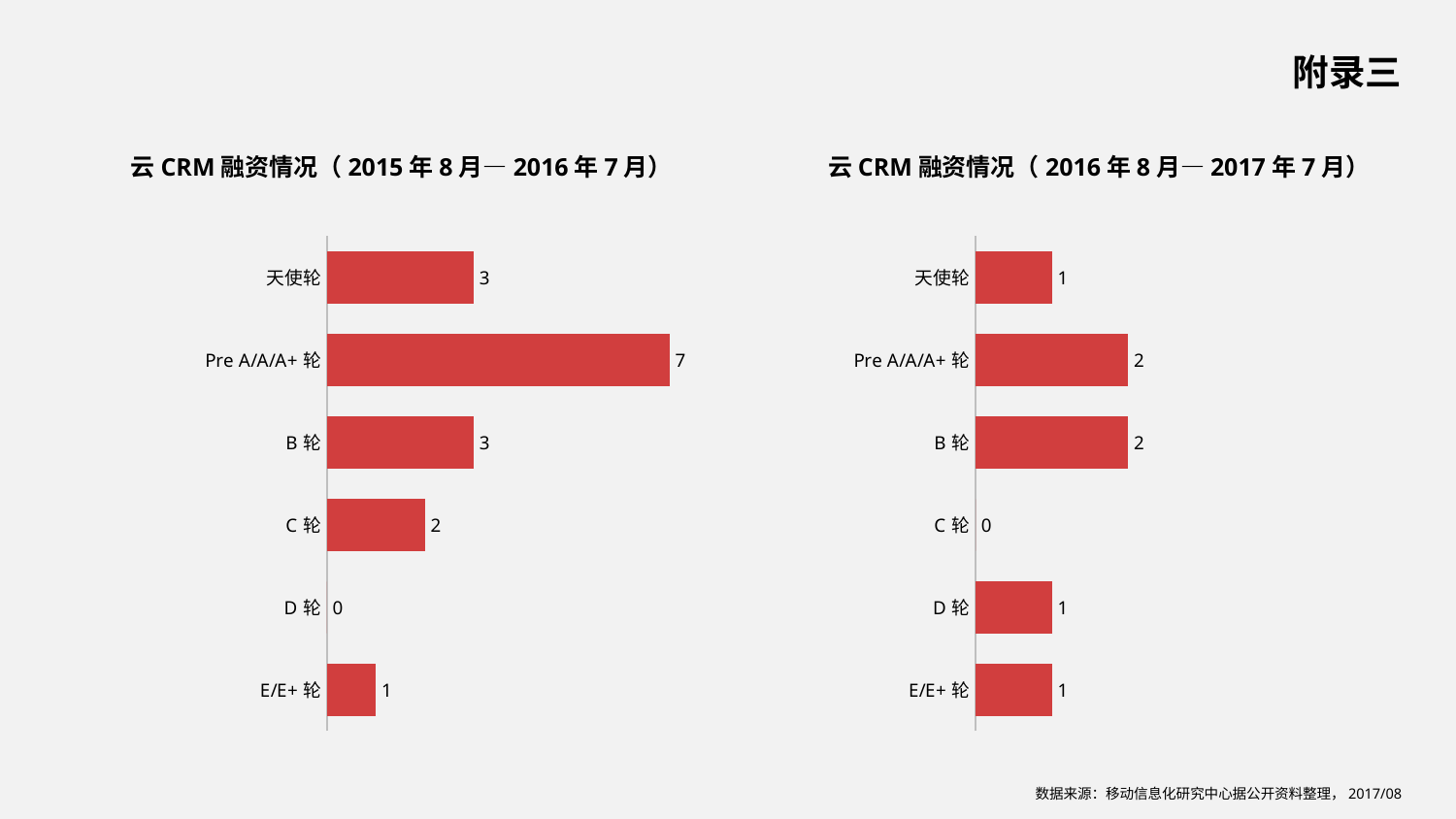
In the left chart (2015年8月—2016年7月), which category has the lowest value? D 轮 What is the title of the right chart? 云 CRM 融资情况（2016 年 8 月— 2017 年 7 月） In the left chart (2015年8月—2016年7月), what is the difference between Pre A/A/A+ 轮 and C 轮? 5 In the right chart (2016年8月—2017年7月), what is the difference between B 轮 and E/E+ 轮? 1 What type of chart is used on the left side of the slide? Bar chart In the left chart (2015年8月—2016年7月), how many categories are shown? 6 In the right chart (2016年8月—2017年7月), which category has the lowest value? C 轮 In the left chart (云 CRM 融资情况 2015年8月—2016年7月), what is the value for Pre A/A/A+ 轮? 7 In the right chart (2016年8月—2017年7月), what is the value for D 轮? 1 Which is larger: the value for B 轮 in the left chart or the value for B 轮 in the right chart? Left chart (3) In the right chart (云 CRM 融资情况 2016年8月—2017年7月), what is the value for 天使轮? 1 In the left chart (2015年8月—2016年7月), which category has the highest value? Pre A/A/A+ 轮